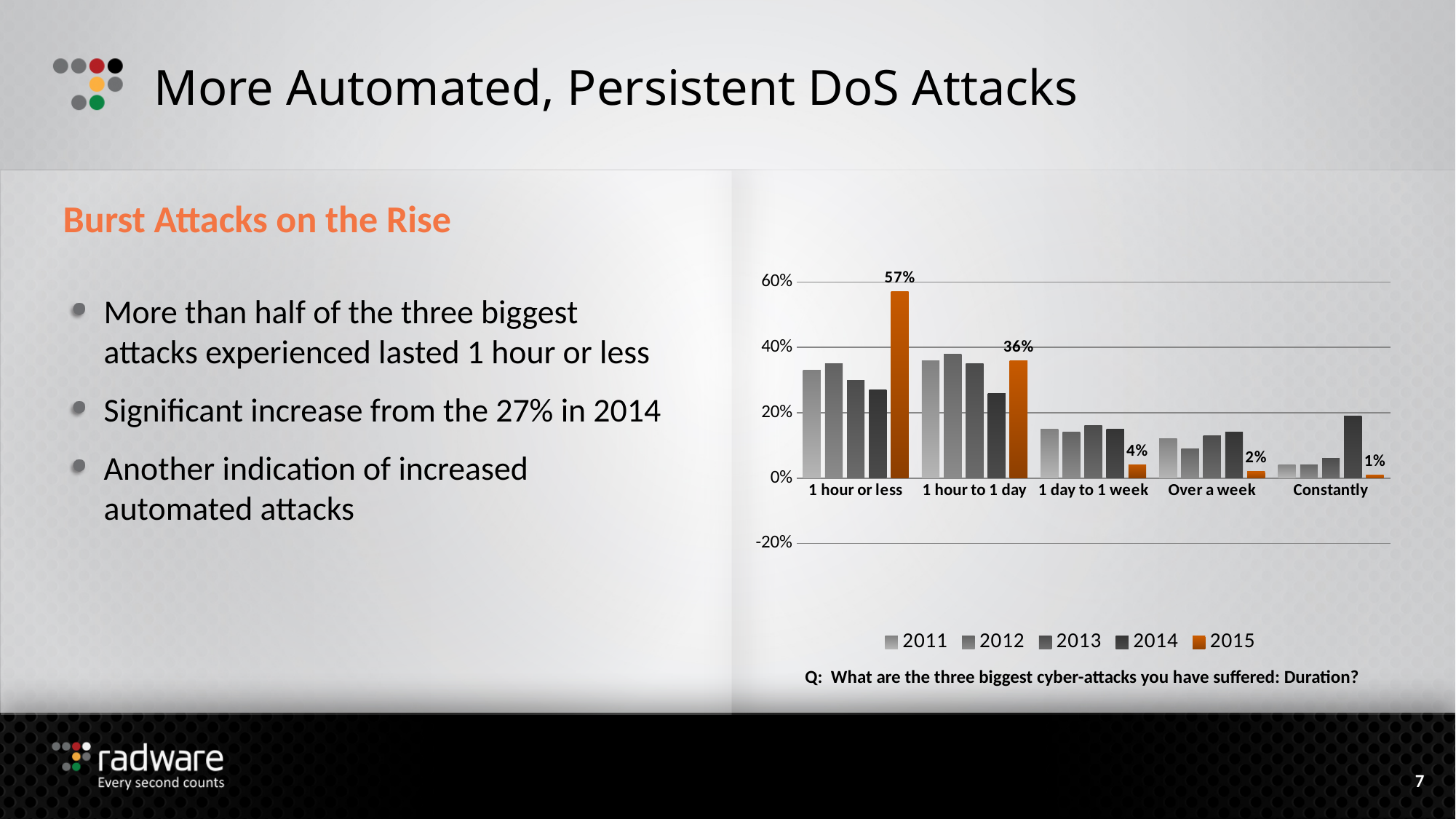
Which duration category has the highest 2015 value? 1 hour or less What is the 2015 value for "1 hour to 1 day"? 36% How many series does the legend list? 5 What is the 2015 value for "1 hour or less"? 57% What is the 2015 value for "1 day to 1 week"? 4% How many duration categories are shown on the x axis? 5 Which duration category has the lowest 2015 value? Constantly Is the 2011 value for "1 hour or less" greater or less than 20%? greater What is the 2015 value for "Constantly"? 1% Is the 2014 value for "1 hour or less" greater or less than 40%? less Which series is shown in orange? 2015 What is the difference between the 2015 values for "1 hour or less" and "1 hour to 1 day"? 21%